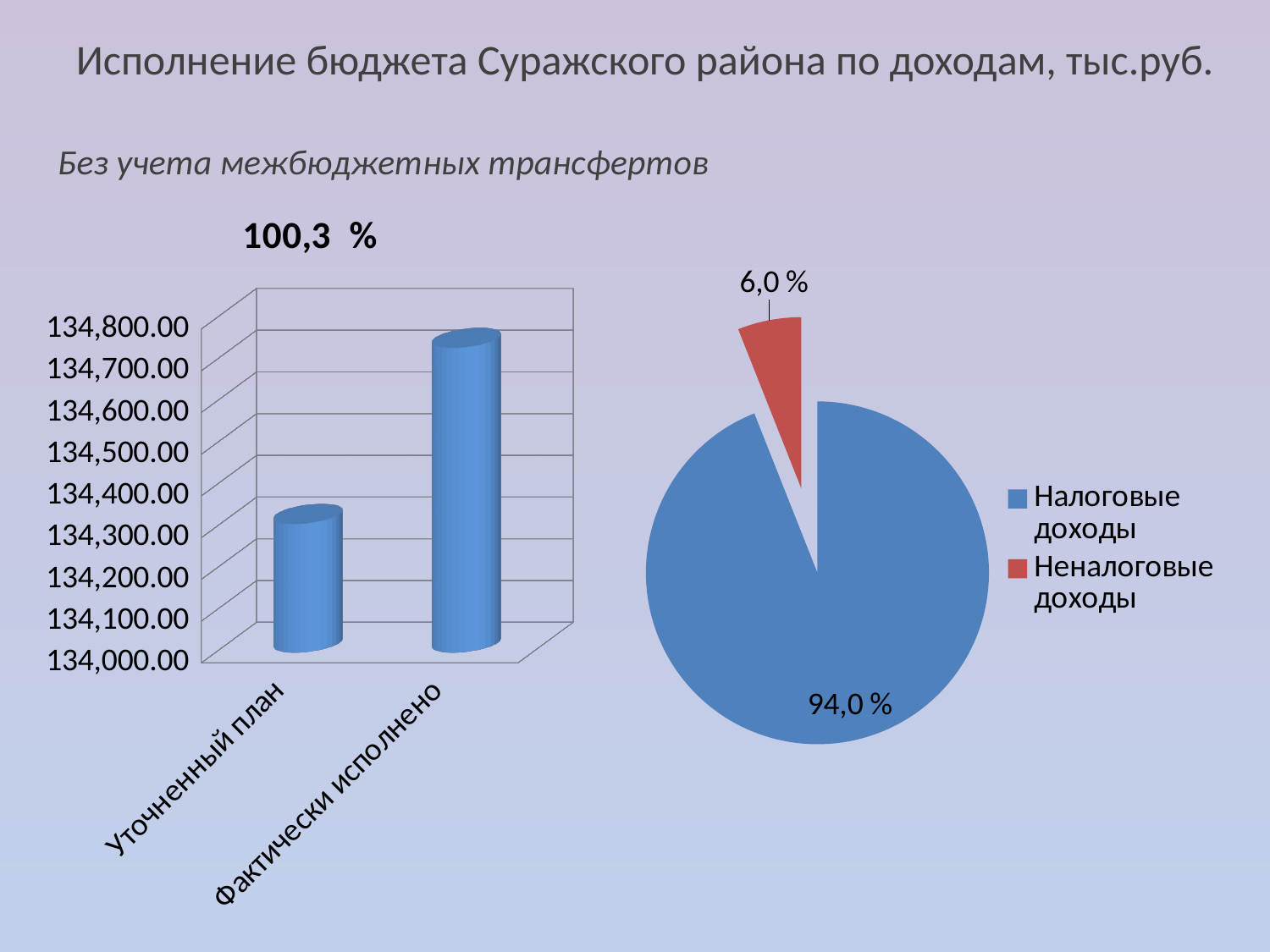
In the pie chart on the right, which slice is the largest? Налоговые доходы In the bar chart on the left, is the value for Фактически исполнено greater or less than 134,600.00? greater In the bar chart on the left, which category has the lowest value? Уточненный план In the pie chart on the right, what share does Налоговые доходы have? 94,0 % In the bar chart on the left, is the value for Уточненный план greater or less than 134,400.00? less In the bar chart on the left, which category has the higher value: Уточненный план or Фактически исполнено? Фактически исполнено In the bar chart on the left, how many categories are shown? 2 What kind of chart is the chart on the left side of the slide? bar chart What percentage is printed above the bar chart on the left? 100,3 % In the pie chart on the right, how many entries does the legend list? 2 In the pie chart on the right, what share does Неналоговые доходы have? 6,0 % What kind of chart is the chart on the right side of the slide? pie chart